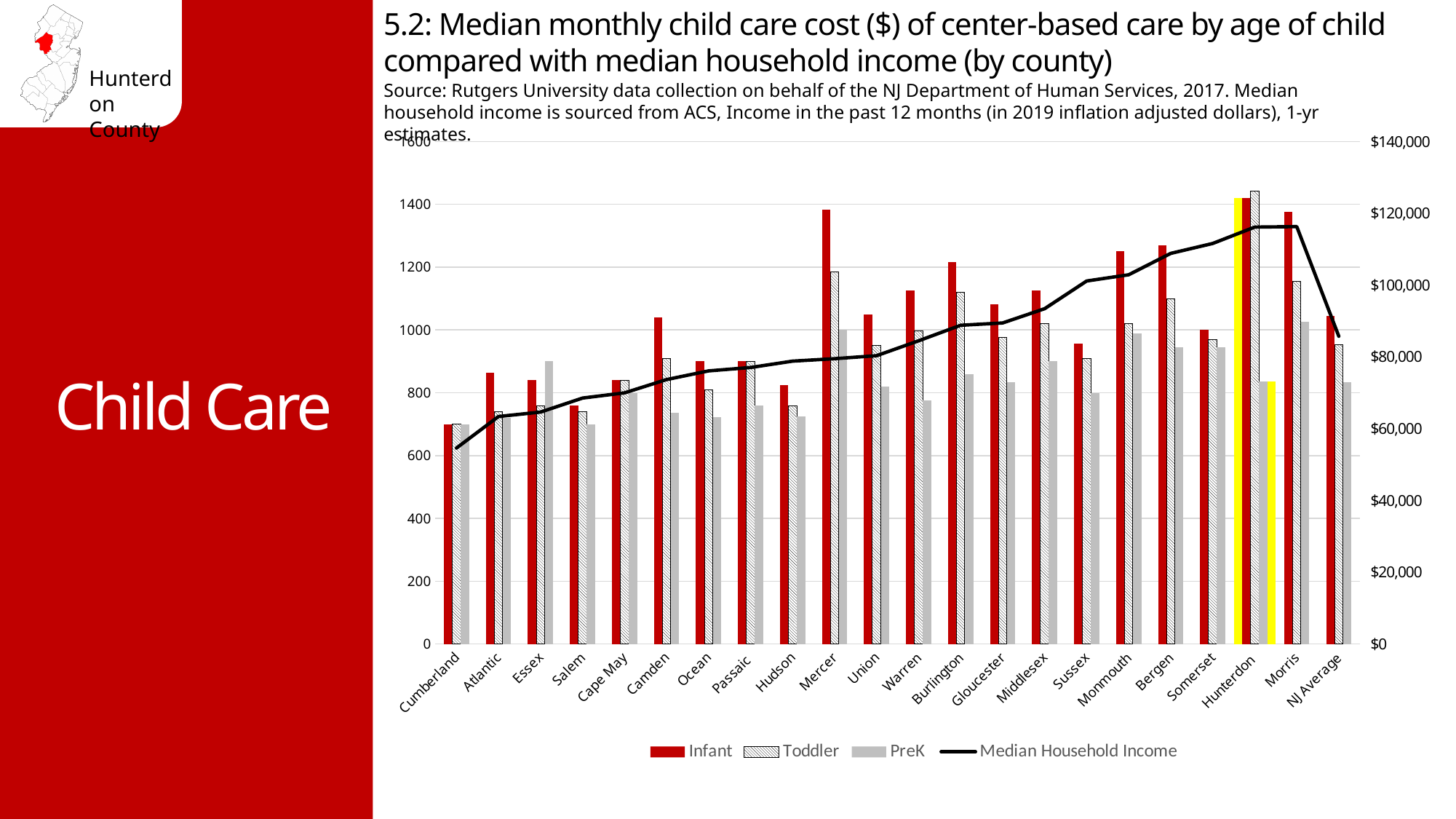
Is the Median Household Income for Hunterdon greater or less than $100,000? greater For Mercer, which is larger: the Infant cost or the Toddler cost? Infant Which county has the highest Toddler child care cost? Hunterdon How many counties/categories are shown on the x axis of the chart? 22 Is the Median Household Income for Cumberland greater or less than $60,000? less How many series does the chart's legend list? 4 Which county has the lowest Infant child care cost? Cumberland Does the Median Household Income line generally rise or fall from Cumberland to Morris? rise What kind of chart is used to show the child care costs? bar chart (with a line for median household income) Is the Infant cost for Cumberland greater or less than 800? less Which county's bars are highlighted in yellow on the chart? Hunterdon